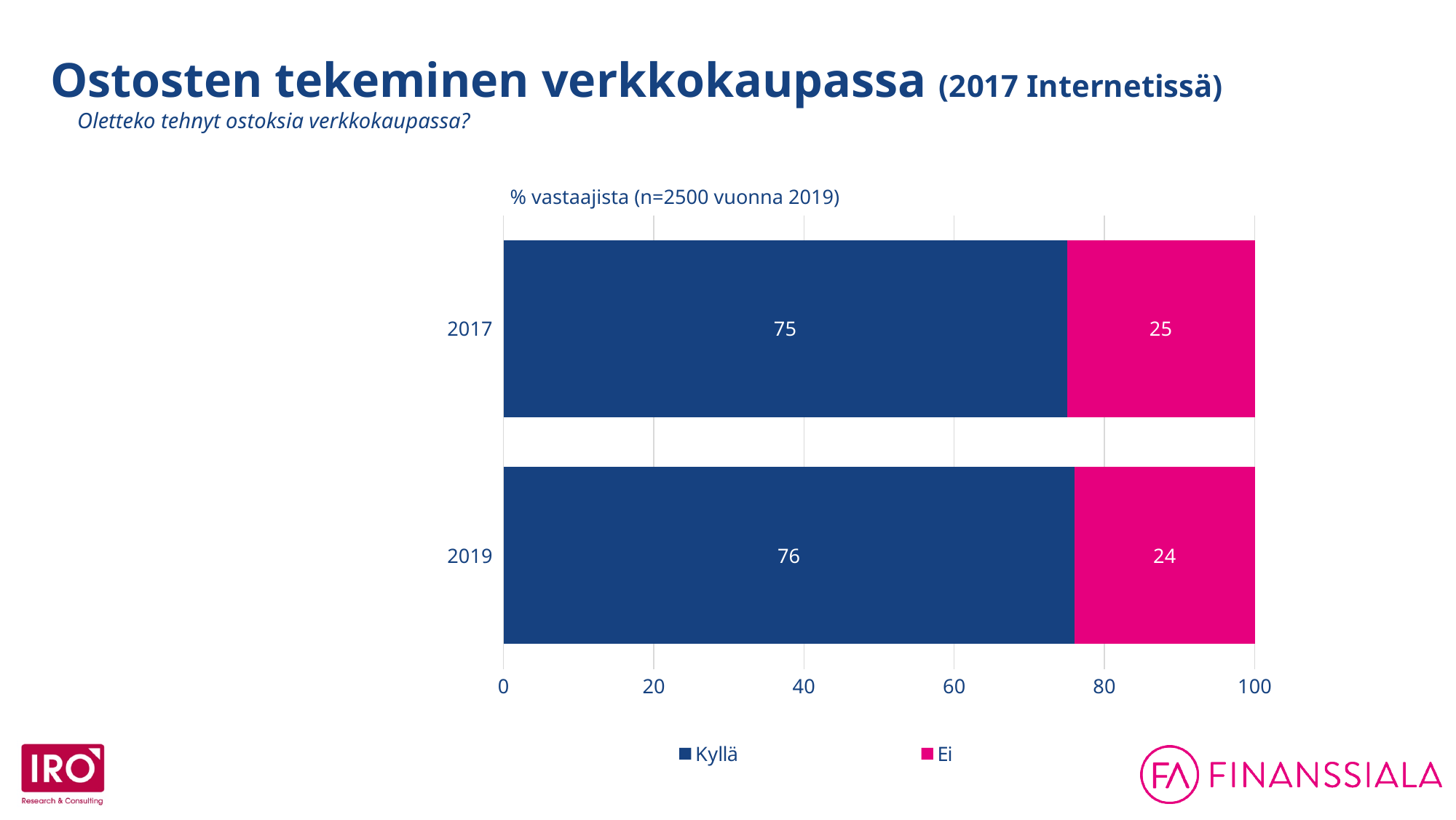
What is the total of the stacked bar for 2019? 100 What kind of chart is shown on the slide? Stacked bar chart Which year has the higher value for Kyllä? 2019 What is the value for Ei in 2019? 24 What is the difference between the Kyllä values for 2019 and 2017? 1 Is the Kyllä value for 2017 larger or smaller than the Ei value for 2017? larger How many years are shown on the chart? 2 How many series does the legend list? 2 What is the value for Kyllä in 2019? 76 What is the value for Ei in 2017? 25 What is the value for Kyllä in 2017? 75 Which year has the lower value for Ei? 2019